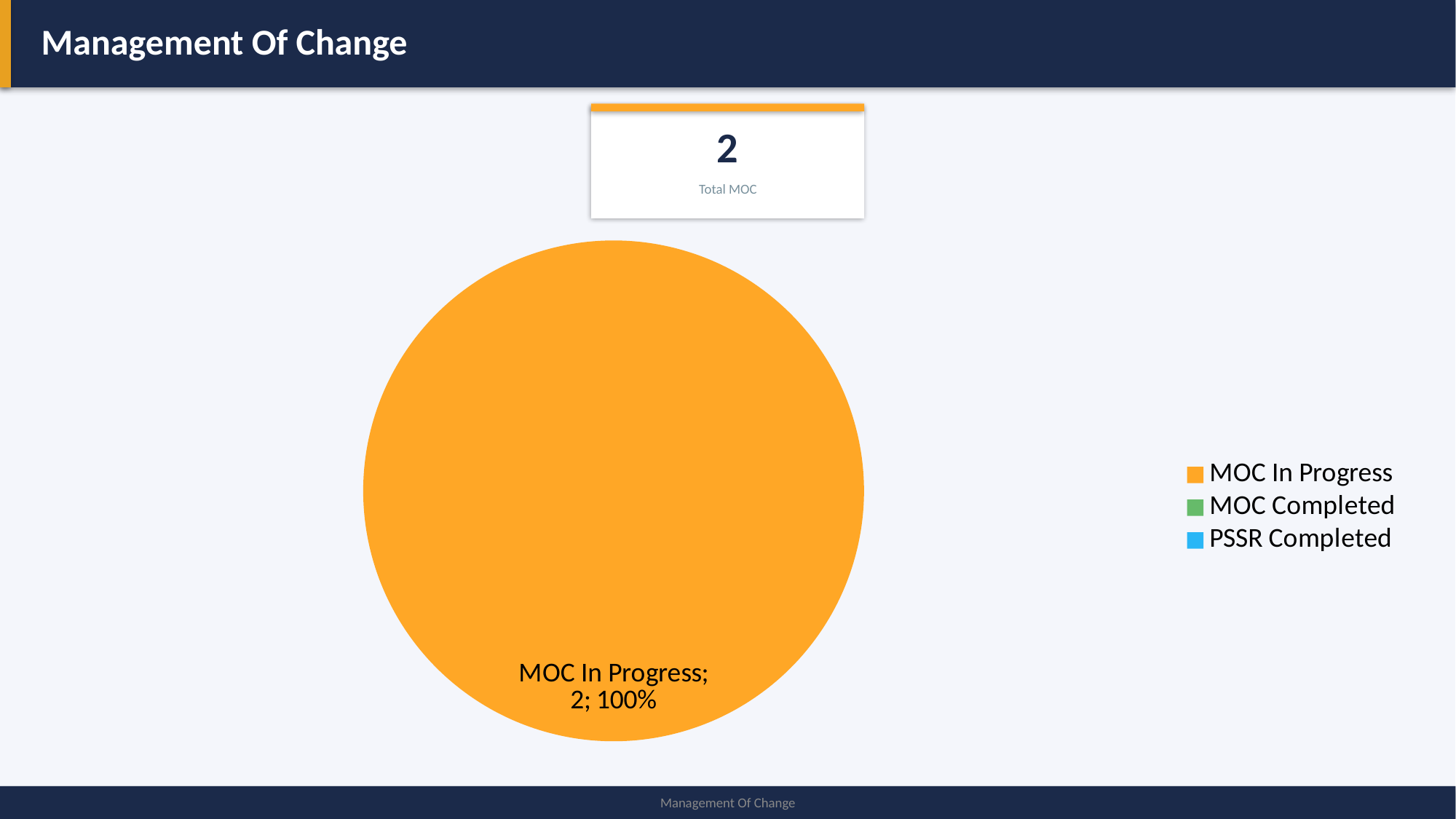
How many slices are visible in the pie chart? 1 What is the value for MOC In Progress in the pie chart? 2 Which legend entry is shown in green? MOC Completed What share of the pie does MOC In Progress represent? 100% What kind of chart is shown on the slide? pie chart What colour is the MOC In Progress slice? orange Which category is the largest slice of the pie chart? MOC In Progress What is the Total MOC value shown in the card above the chart? 2 How many entries does the legend list? 3